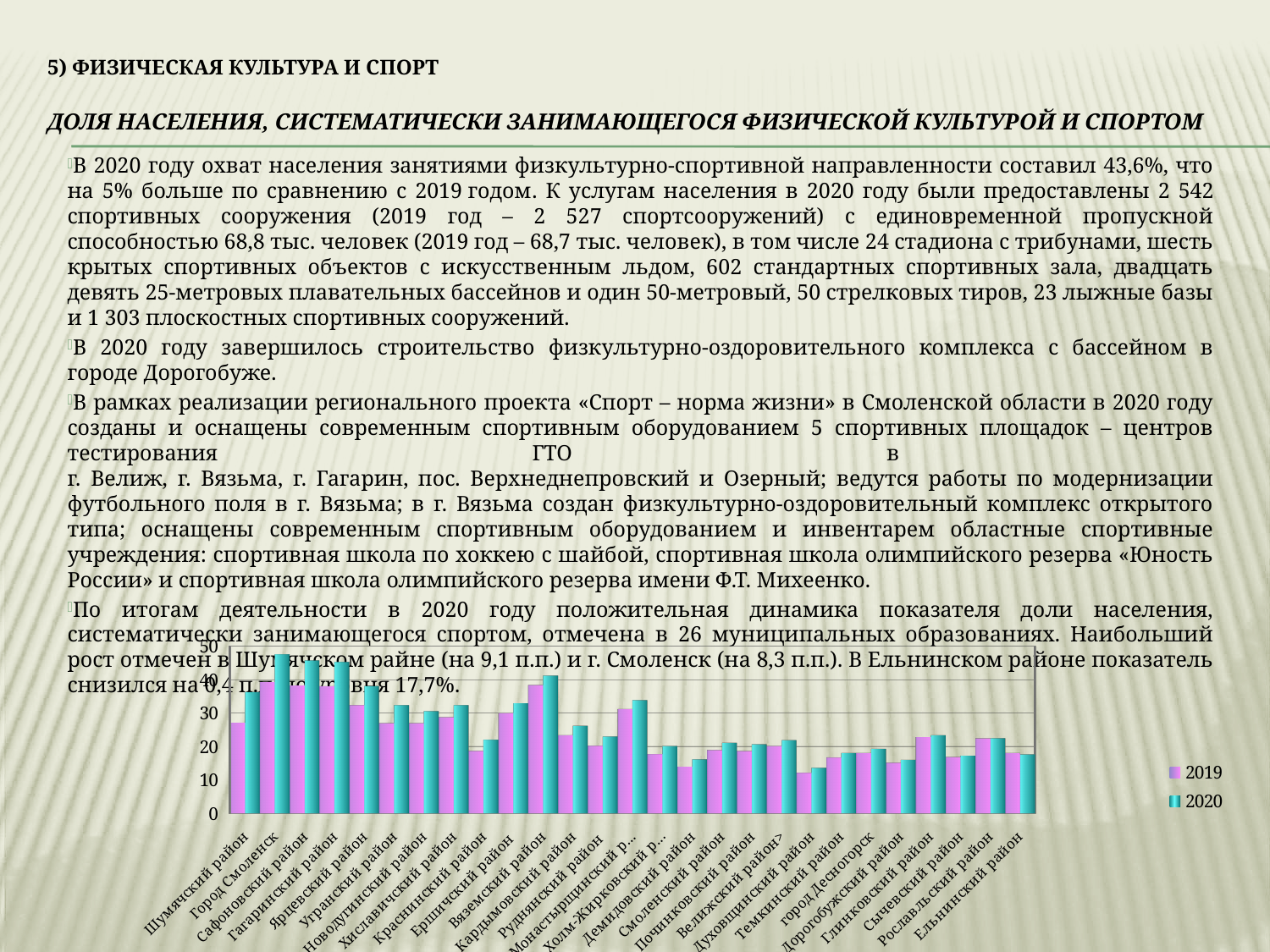
Which has the larger 2020 value, Вяземский район or Кардымовский район? Вяземский район How many series does the chart legend list? 2 Is the 2020 value for Шумячский район greater or less than 30? greater Is the 2019 value for Шумячский район greater or less than 30? less What kind of chart is shown on the slide? bar chart How many municipal districts (categories) are shown on the x axis of the chart? 27 Is the 2019 value for Темкинский район greater or less than 20? less For Шумячский район, which series has the larger value, 2019 or 2020? 2020 Do the 2020 values generally rise or fall moving from left to right along the x axis? fall Which years are listed in the chart legend? 2019 and 2020